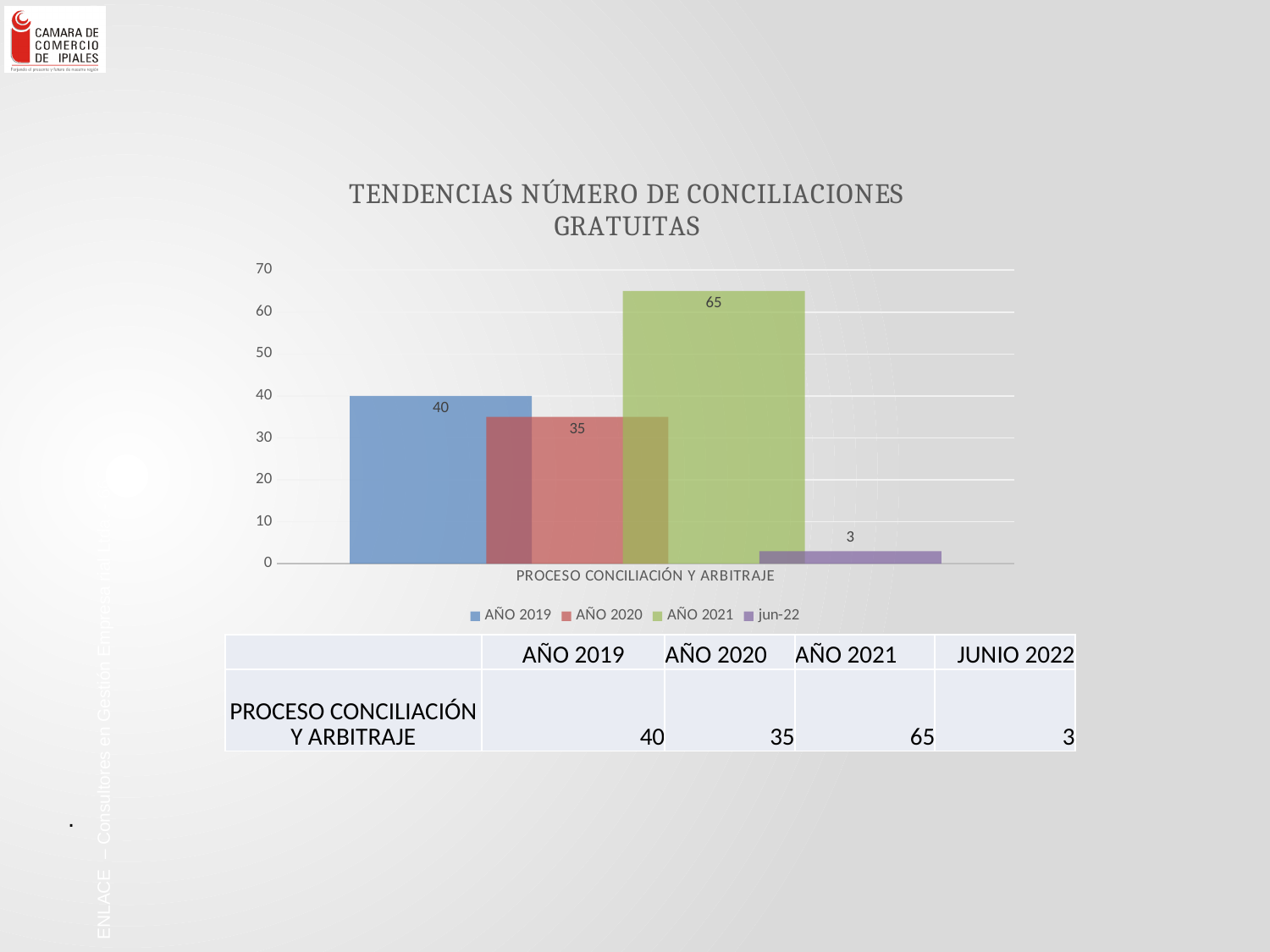
What is the value for AÑO 2019 in the chart? 40 What is the difference between the values for AÑO 2021 and AÑO 2020? 30 What kind of chart is shown on the slide? Bar chart What is the value for jun-22 in the chart? 3 What is the title of the chart? TENDENCIAS NÚMERO DE CONCILIACIONES GRATUITAS Which series has the lowest value in the chart? jun-22 What is the value for AÑO 2020 in the chart? 35 What is the value for AÑO 2021 in the chart? 65 What is the category label on the x axis of the chart? PROCESO CONCILIACIÓN Y ARBITRAJE Which series has the highest value in the chart? AÑO 2021 Which is larger, the value for AÑO 2019 or the value for AÑO 2020? AÑO 2019 How many series does the legend list? 4